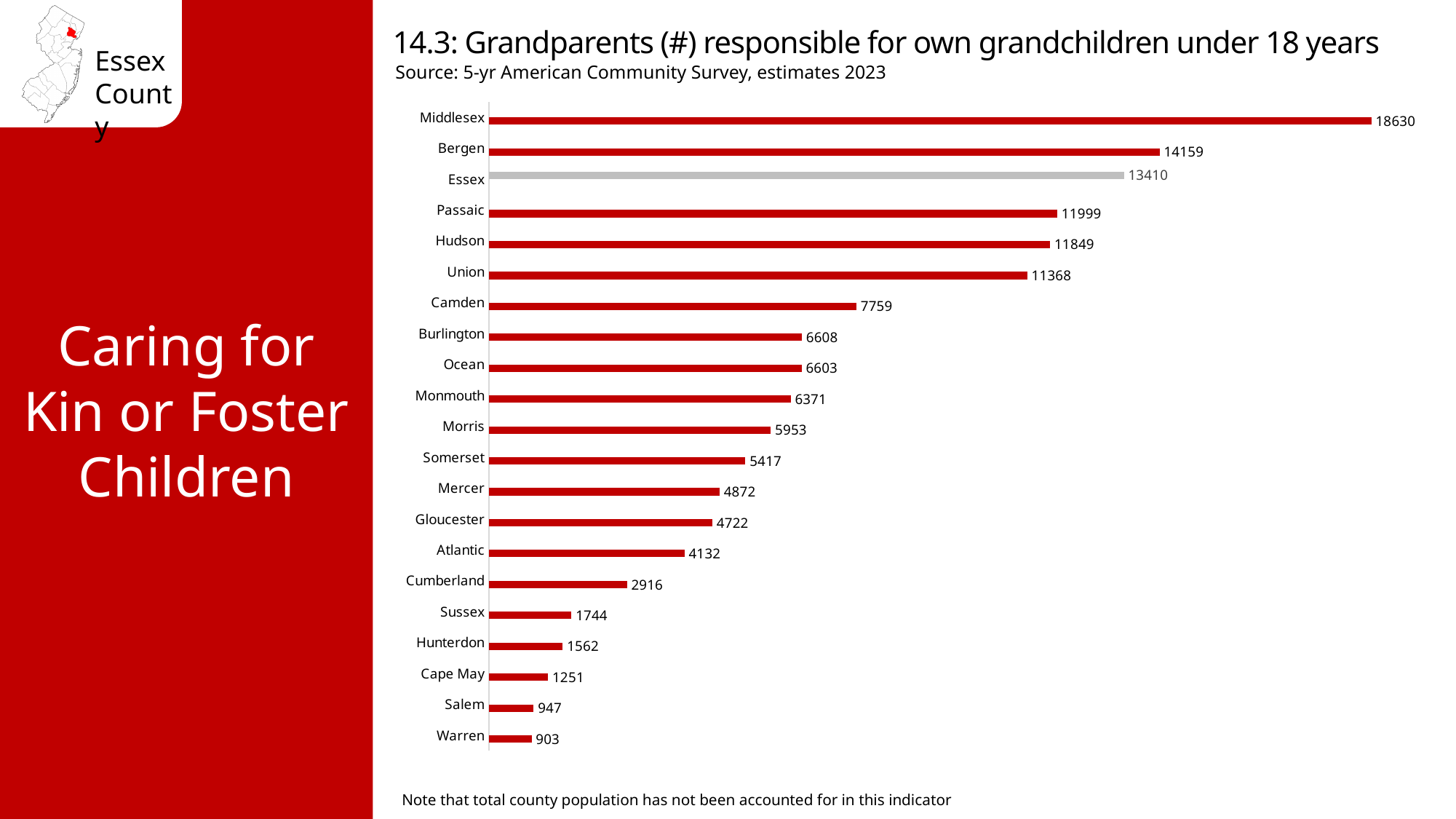
Which is larger, the value for Sussex or the value for Hunterdon? Sussex How many counties are shown in the chart? 21 Which county has the highest value? Middlesex What is the value for Essex? 13410 What is the difference between the values for Middlesex and Bergen? 4471 What kind of chart is shown on the slide? Bar chart Which county's bar is coloured grey instead of red? Essex What is the value for Camden? 7759 Which county has the lowest value? Warren Which is larger, the value for Passaic or the value for Hudson? Passaic What is the value for Cape May? 1251 What is the difference between the values for Essex and Union? 2042